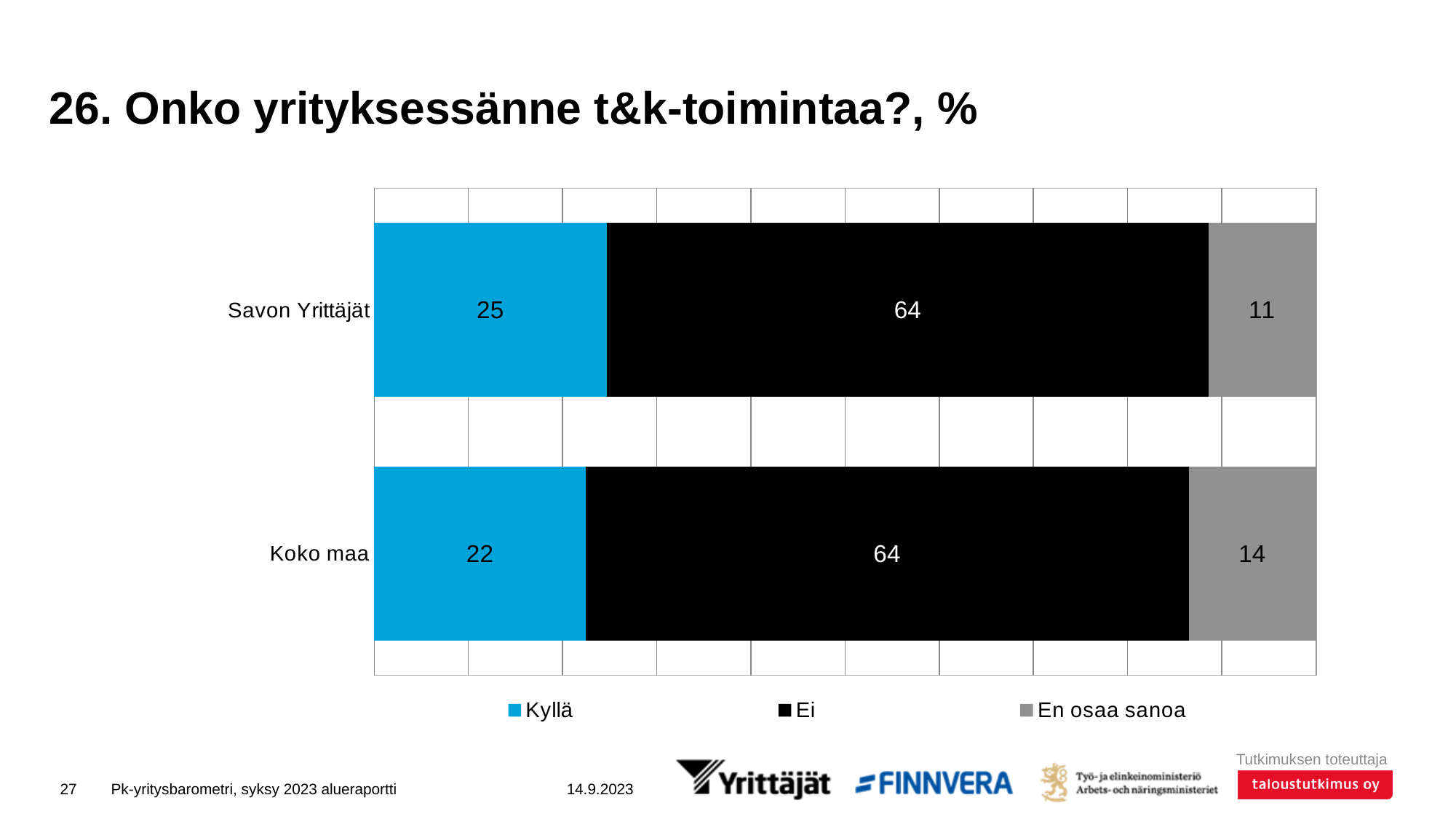
What is the value for Kyllä for Savon Yrittäjät? 25 Which series has the smallest value for Koko maa? En osaa sanoa What is the value for Ei for Koko maa? 64 How many series does the legend list? 3 What is the total of the stacked bar for Savon Yrittäjät? 100 What is the value for En osaa sanoa for Savon Yrittäjät? 11 What kind of chart is shown on the slide? Stacked bar chart Which series has the largest value for Savon Yrittäjät? Ei Which category has the higher Kyllä value, Savon Yrittäjät or Koko maa? Savon Yrittäjät What is the value for En osaa sanoa for Koko maa? 14 What is the difference between the En osaa sanoa values for Koko maa and Savon Yrittäjät? 3 What is the difference between the Kyllä values for Savon Yrittäjät and Koko maa? 3